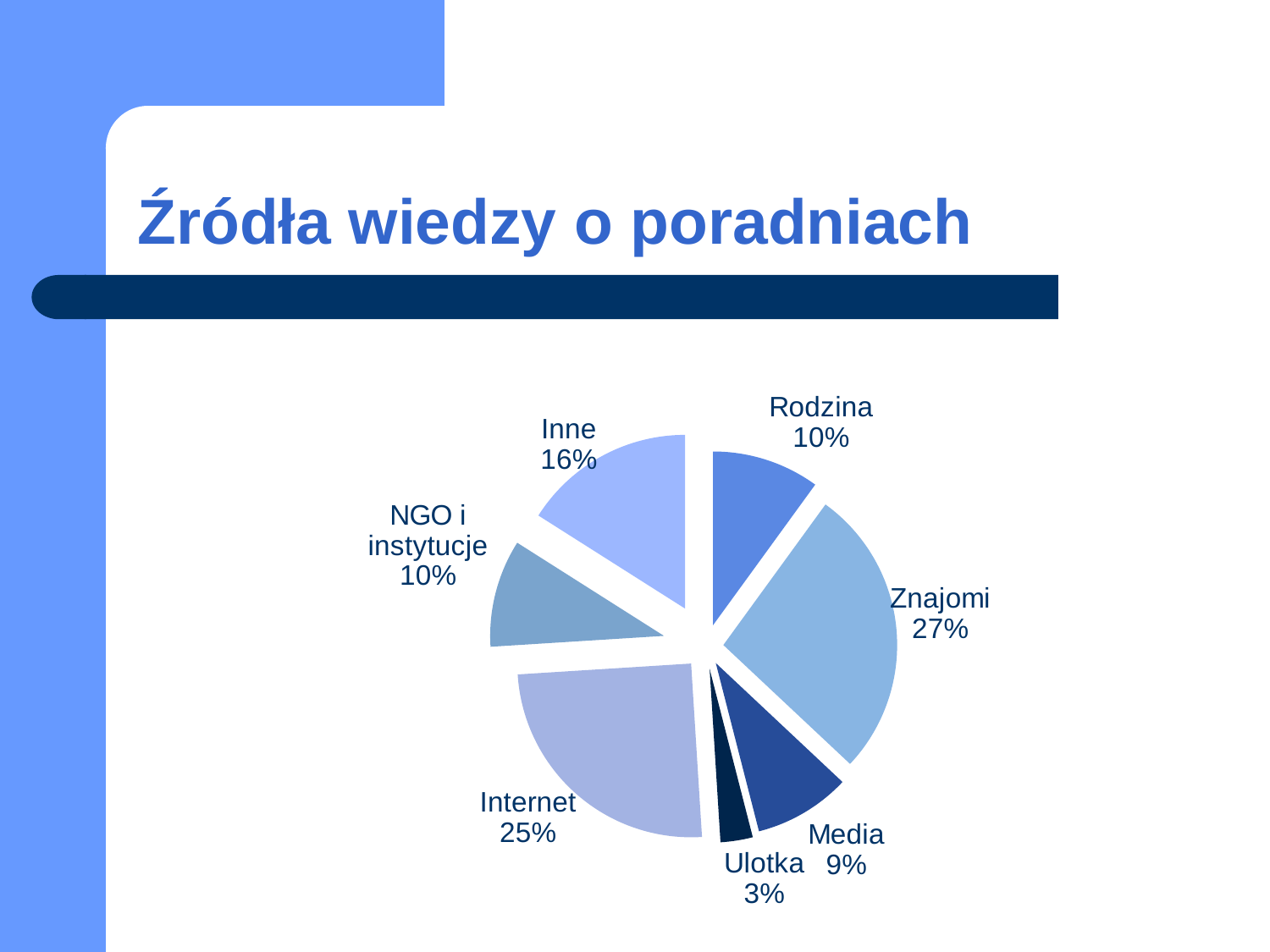
What is the value for Inne? 16% What is the value for Ulotka? 3% How many categories are shown in the pie chart? 7 Which category has the largest slice of the pie? Znajomi What share of the pie does Znajomi have? 27% What is the difference between the values for Znajomi and Internet? 2% What is the title of the slide containing the chart? Źródła wiedzy o poradniach What is the difference between the values for Inne and Media? 7% What kind of chart is shown on the slide? Pie chart What is the value for Internet? 25% Which category has the smallest slice of the pie? Ulotka Which is larger, Media or Rodzina? Rodzina